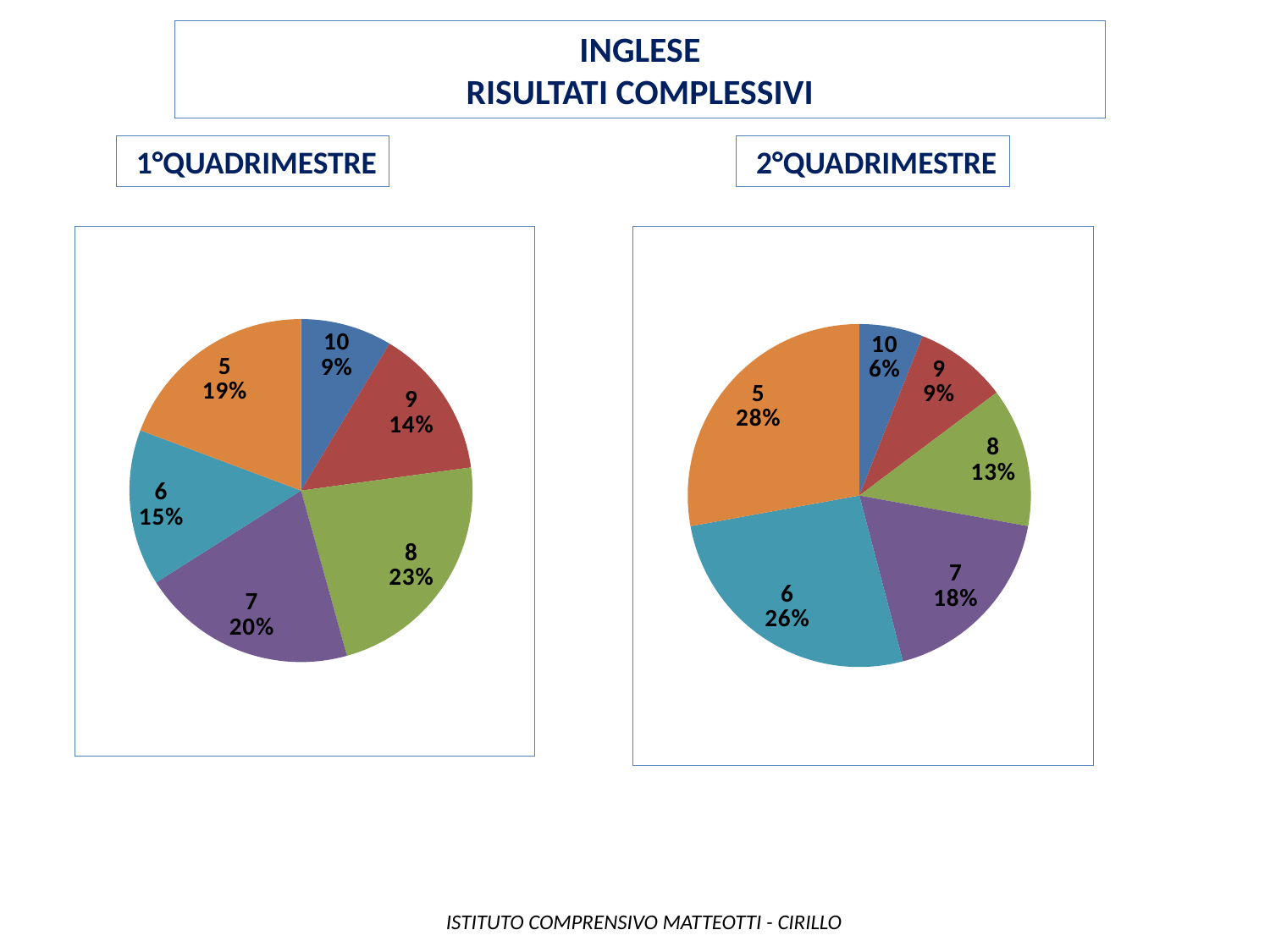
How many slices does the 1°QUADRIMESTRE pie chart have? 6 What is the title shown at the top of the slide? INGLESE RISULTATI COMPLESSIVI In the 2°QUADRIMESTRE pie chart, which grade has the largest share? 5 In the 1°QUADRIMESTRE pie chart, what share does grade 8 have? 23% In the 2°QUADRIMESTRE pie chart, what share does grade 10 have? 6% What kind of chart is used for the 2°QUADRIMESTRE results? Pie chart In the 1°QUADRIMESTRE pie chart, which grade has the smallest share? 10 In the 1°QUADRIMESTRE pie chart, what is the difference in percentage points between grade 7 and grade 6? 5 In the 2°QUADRIMESTRE pie chart, which has the larger share, grade 6 or grade 7? 6 In the 1°QUADRIMESTRE pie chart, which grade has the largest share? 8 In the 2°QUADRIMESTRE pie chart, what share does grade 5 have? 28% In the 2°QUADRIMESTRE pie chart, which grade has the smallest share? 10